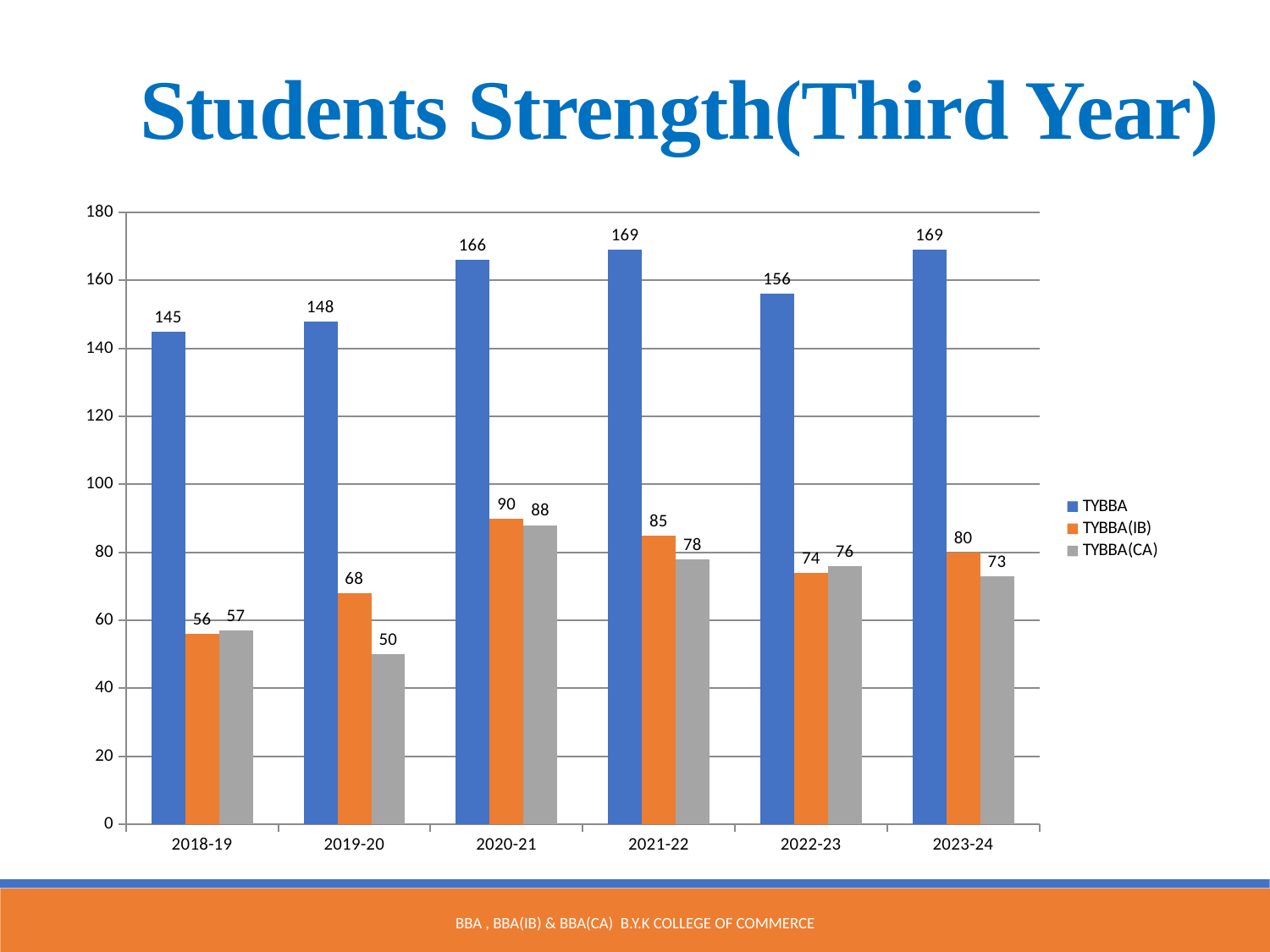
Which is larger, the TYBBA(IB) value for 2022-23 or the TYBBA(CA) value for 2022-23? TYBBA(CA) for 2022-23 What is the difference between the TYBBA values for 2021-22 and 2018-19? 24 Which year has the highest TYBBA(IB) value? 2020-21 Which year has the lowest TYBBA value? 2018-19 How many series does the legend list? 3 Which year has the lowest TYBBA(CA) value? 2019-20 What is the title of the chart on the slide? Students Strength(Third Year) What is the TYBBA(CA) value for 2023-24? 73 How many years are shown on the x axis? 6 What is the TYBBA(IB) value for 2019-20? 68 What kind of chart is shown on the slide? Bar chart What is the TYBBA value for 2020-21? 166